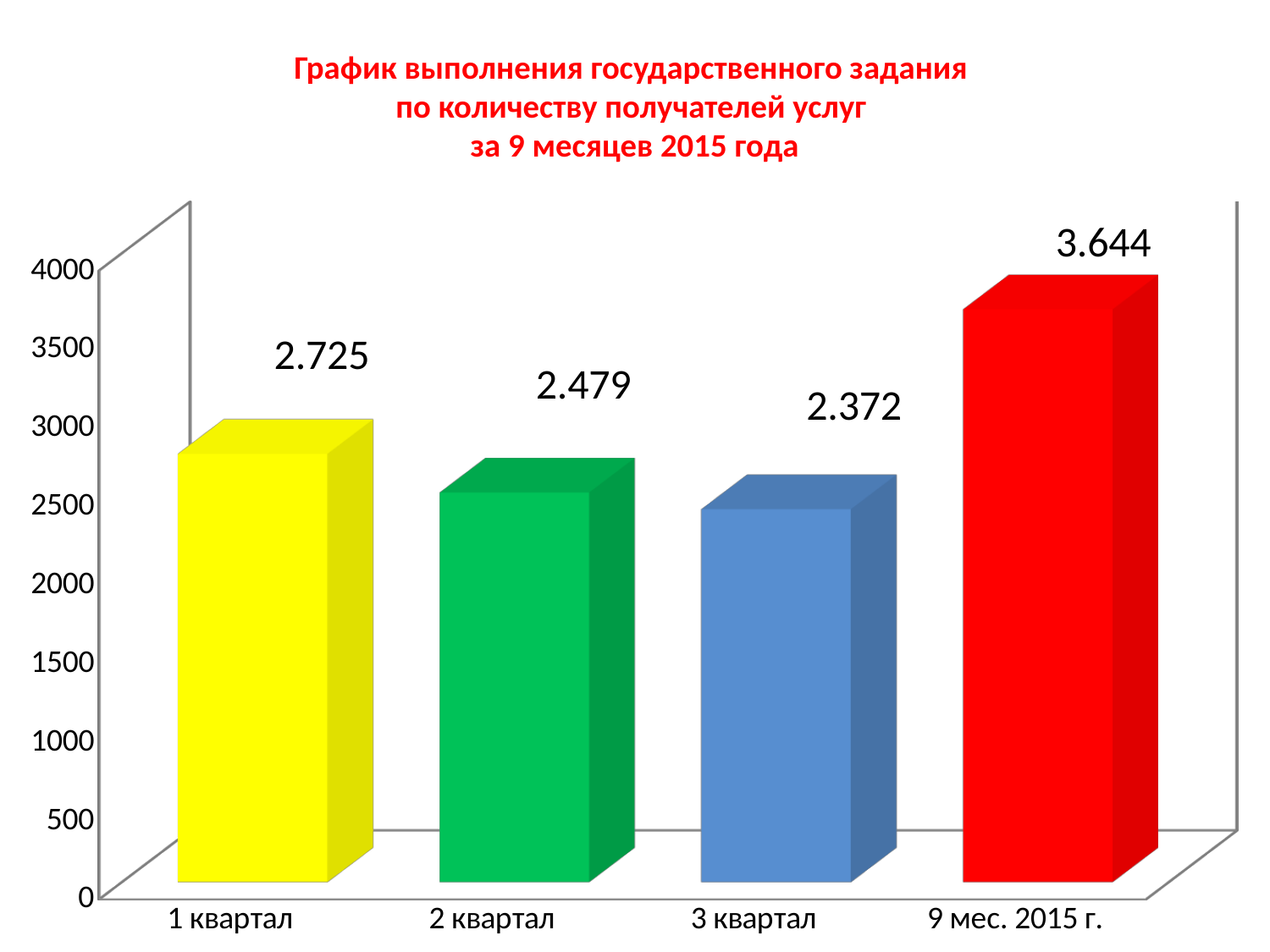
What is the difference between the values for 1 квартал and 2 квартал? 246 What is the value for 3 квартал? 2.372 Which is larger, the value for 2 квартал or the value for 3 квартал? 2 квартал What is the value for 9 мес. 2015 г.? 3.644 Which category has the lowest value? 3 квартал What is the value for 1 квартал? 2.725 Is the value for 3 квартал greater or less than 2500? less What is the value for 2 квартал? 2.479 How many categories are shown on the x axis? 4 Do the values rise or fall from 1 квартал to 3 квартал? fall Which category has the highest value? 9 мес. 2015 г. What kind of chart is shown on the slide? bar chart